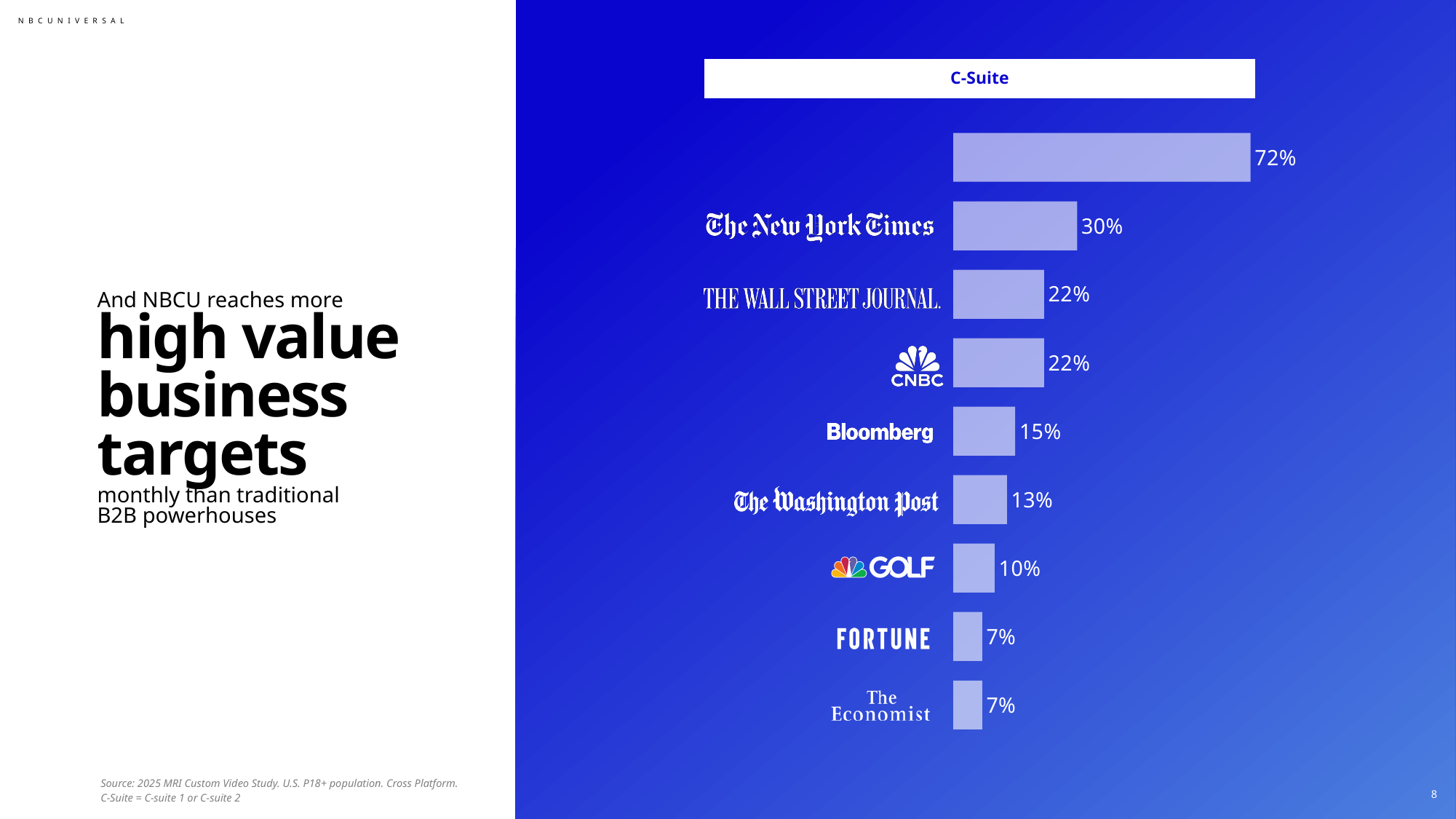
What is the title shown above the chart? C-Suite What is the value for Bloomberg? 15% What is the difference between the values for The Washington Post and The Economist? 6% What is the value for Fortune? 7% What is the value for The New York Times? 30% How many bars are plotted in the chart? 9 What is the value shown on the topmost bar of the chart? 72% What kind of chart is shown on the slide? bar chart What is the value for The Wall Street Journal? 22% Which has a larger value, Bloomberg or Golf? Bloomberg What is the difference between the values for The New York Times and CNBC? 8% What is the value for The Washington Post? 13%